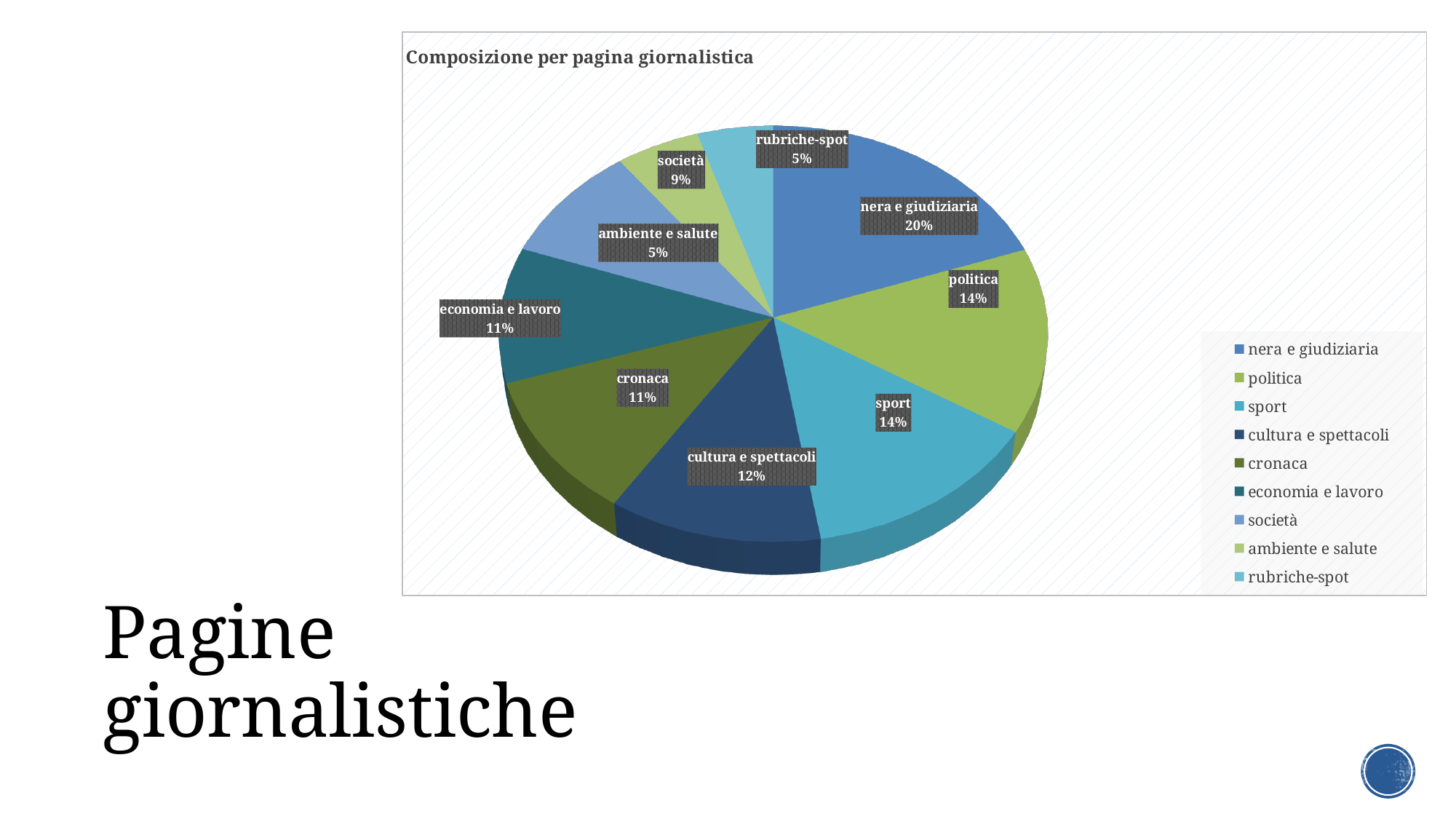
Which category has the largest slice of the pie? nera e giudiziaria What is the title of the chart? Composizione per pagina giornalistica What share of the pie does 'nera e giudiziaria' represent? 20% How many categories does the pie chart show? 9 What percentage is shown for 'società'? 9% What is the difference in percentage points between 'nera e giudiziaria' and 'sport'? 6 What is the value shown for 'cultura e spettacoli'? 12% What kind of chart is shown on the slide? pie chart What is the combined share of 'politica' and 'sport'? 28% Which is larger, the slice for 'cronaca' or the slice for 'cultura e spettacoli'? cultura e spettacoli What percentage is shown for 'economia e lavoro'? 11% Which two categories share the smallest slice at 5%? ambiente e salute and rubriche-spot